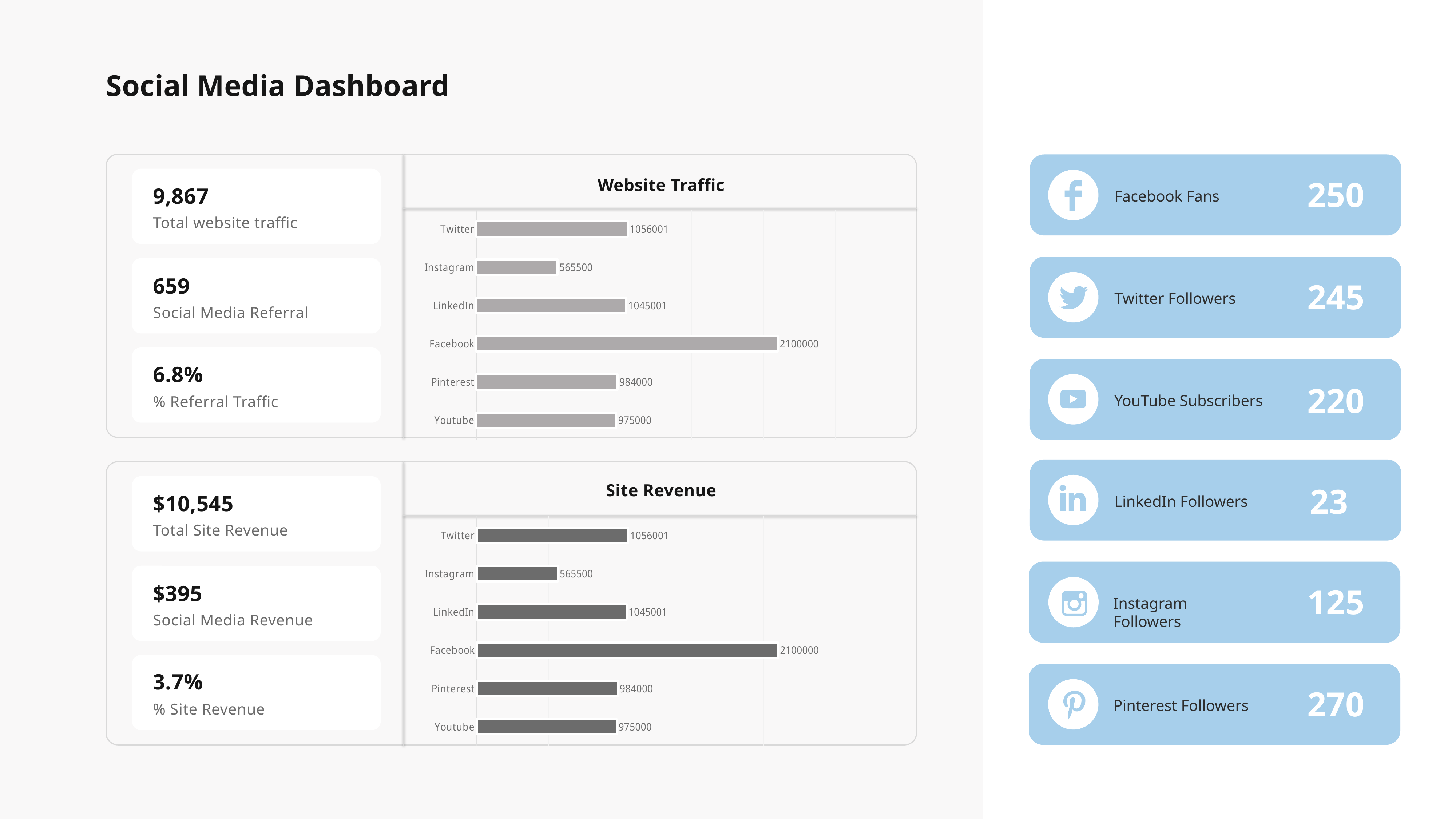
In the Website Traffic chart, which category has the lowest value? Instagram In the Website Traffic chart, what is the value for Facebook? 2100000 In the Website Traffic chart, how many categories are shown? 6 What kind of chart is the Site Revenue chart? Bar chart In the Site Revenue chart, what is the value for Youtube? 975000 In the Website Traffic chart, what is the value for Instagram? 565500 In the Site Revenue chart, what is the difference between the Facebook and Instagram values? 1534500 In the Site Revenue chart, which is larger, the value for Facebook or the value for Twitter? Facebook In the Website Traffic chart, what is the difference between the Twitter and LinkedIn values? 11000 In the Website Traffic chart, which category has the highest value? Facebook What is the title of the lower chart on the slide? Site Revenue In the Site Revenue chart, what is the value for Pinterest? 984000